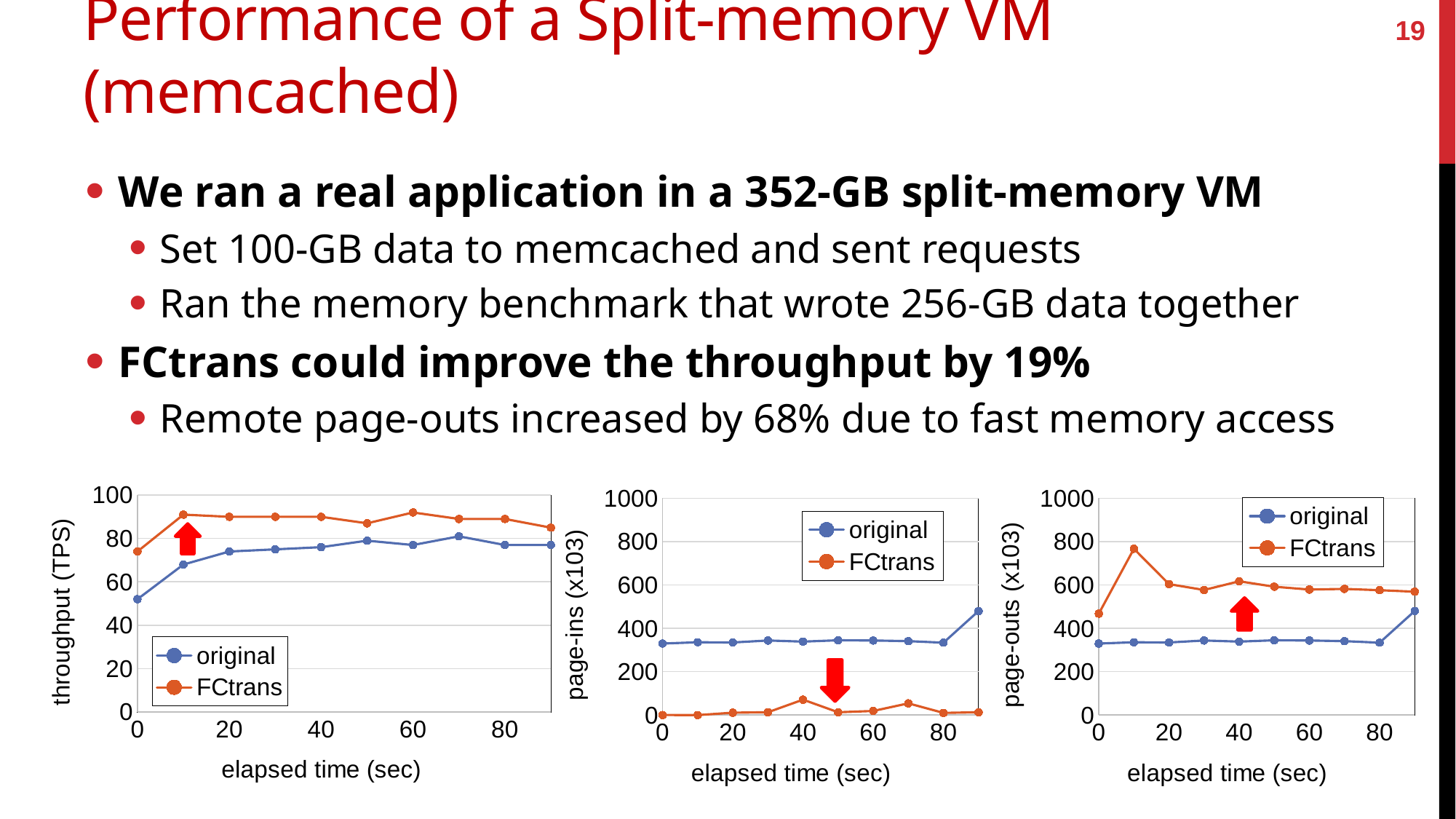
What is the x-axis label of the right chart (page-outs)? elapsed time (sec) In the right chart (page-outs), is the value for original at elapsed time 0 greater or less than 400? less What kind of chart is the left chart (throughput)? line chart In the middle chart (page-ins), which series has the higher value at elapsed time 40, original or FCtrans? original In the left chart (throughput), does the original series generally rise or fall from elapsed time 0 to 90? rise How many series does the legend of the middle chart (page-ins) list? 2 In the left chart (throughput), is the value for original at elapsed time 0 greater or less than 60? less In the left chart (throughput), how many data points does the original series have? 10 In the left chart (throughput), is the value for FCtrans at elapsed time 10 greater or less than 80? greater In the left chart (throughput), which series has the higher value at elapsed time 0, original or FCtrans? FCtrans